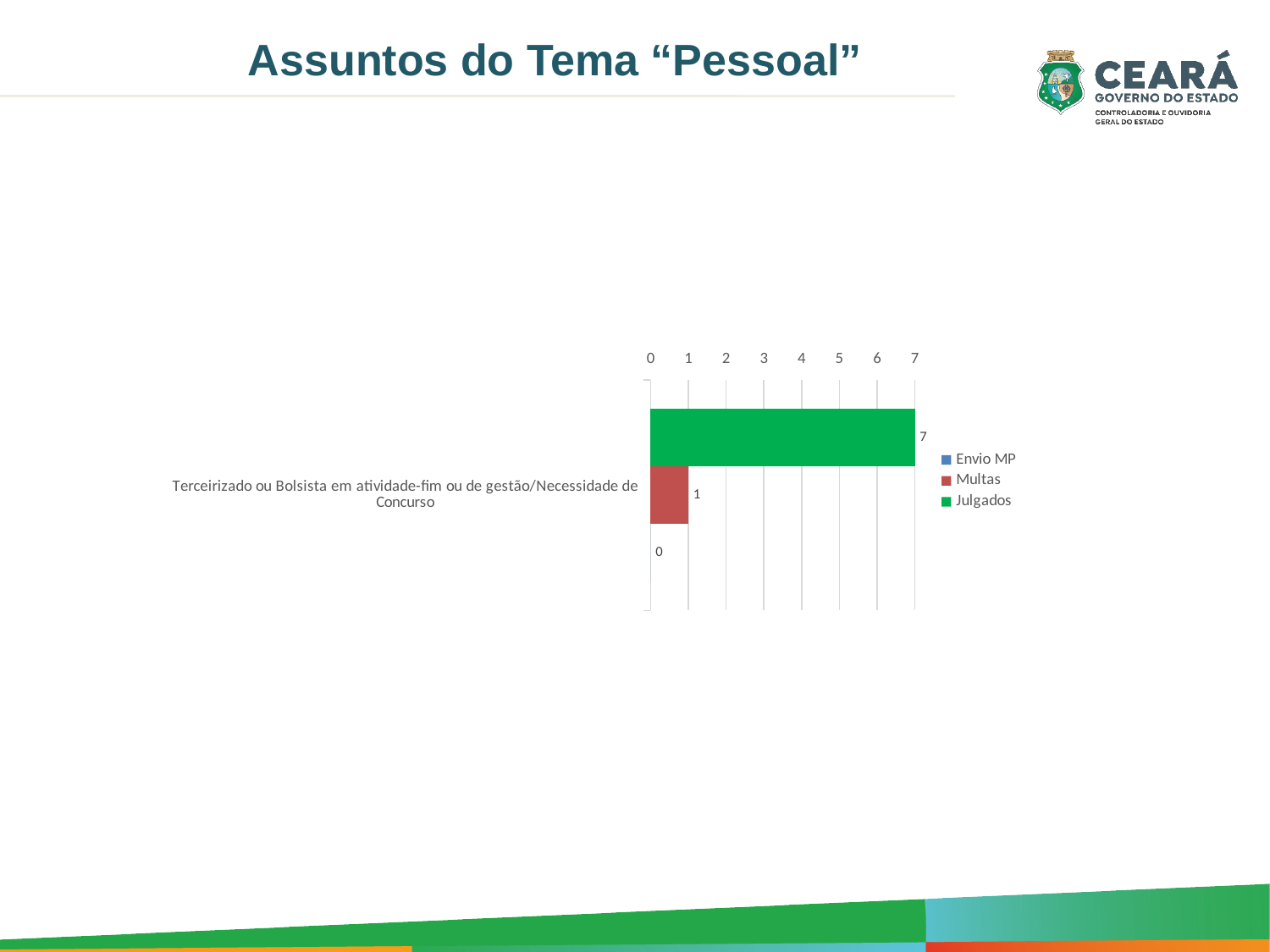
Which series has the lowest value in the chart? Envio MP How many categories are shown on the chart? 1 Which series has the highest value in the chart? Julgados Which is larger, the value for Multas or the value for Julgados? Julgados What kind of chart is shown on the slide? Bar chart What is the title of the slide containing the chart? Assuntos do Tema "Pessoal" Is the value for Julgados greater or less than 5? greater What is the value for Julgados for the category "Terceirizado ou Bolsista em atividade-fim ou de gestão/Necessidade de Concurso"? 7 How many series does the legend list? 3 What is the difference between the Julgados value and the Multas value? 6 What is the value for Multas for the category "Terceirizado ou Bolsista em atividade-fim ou de gestão/Necessidade de Concurso"? 1 What is the value for Envio MP for the category "Terceirizado ou Bolsista em atividade-fim ou de gestão/Necessidade de Concurso"? 0